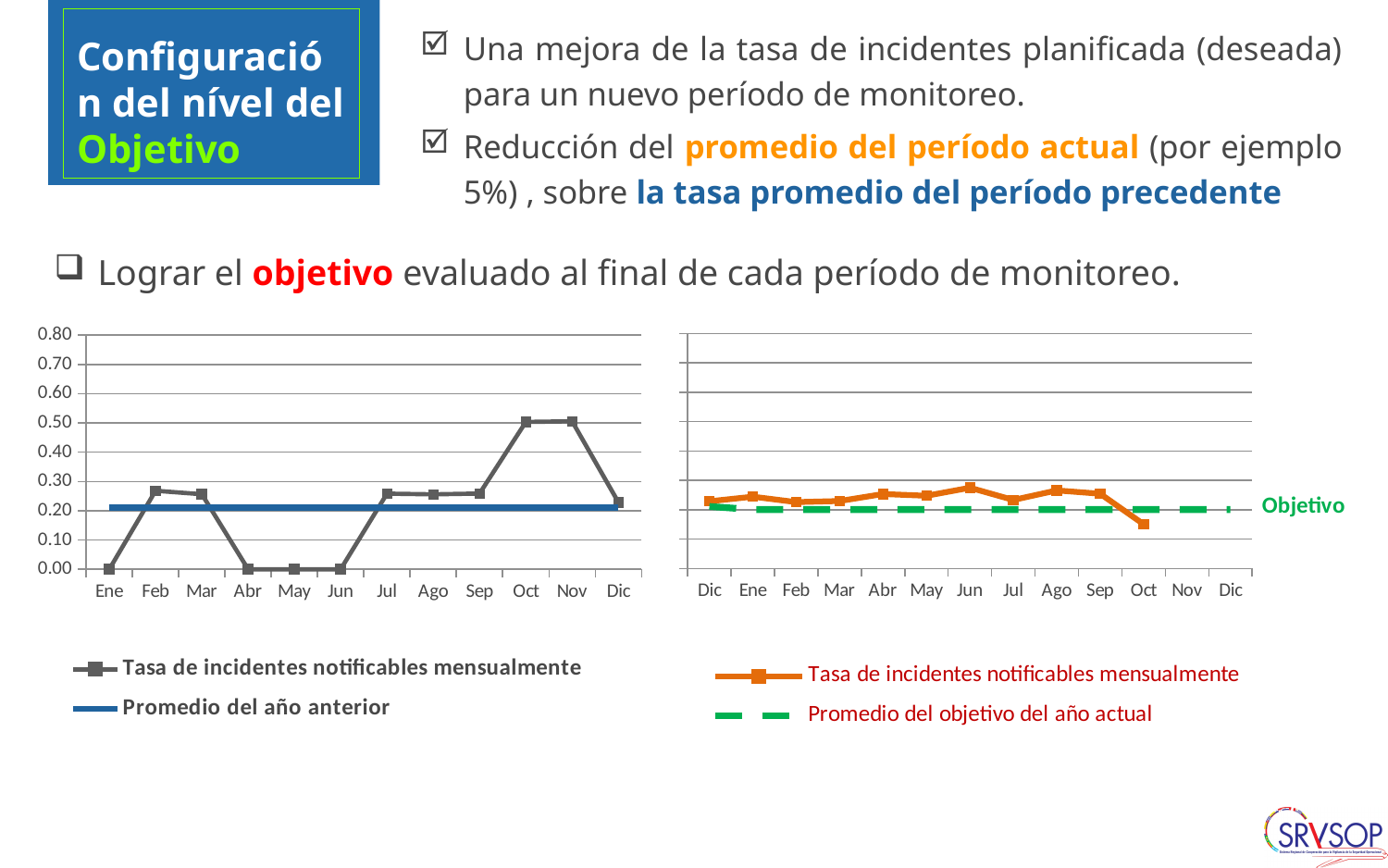
In the right chart, how many series does the legend list? 2 In the left chart, how many series does the legend list? 2 In the left chart, what is the value of Tasa de incidentes notificables mensualmente for Ene? 0.00 In the left chart, is the value of Tasa de incidentes notificables mensualmente for Oct greater or less than 0.40? greater In the left chart, is the value of Tasa de incidentes notificables mensualmente for Feb greater or less than 0.20? greater What kind of chart is the left chart? line chart In the left chart, which is larger, the Tasa de incidentes notificables mensualmente for Oct or for Mar? Oct In the left chart, what is the name of the series drawn as a flat blue line? Promedio del año anterior In the left chart, how many months are shown on the x axis? 12 In the left chart, what is the value of Tasa de incidentes notificables mensualmente for May? 0.00 In the right chart, which month has the lowest value for Tasa de incidentes notificables mensualmente? Oct In the right chart, what is the name of the series drawn as a green dashed line? Promedio del objetivo del año actual